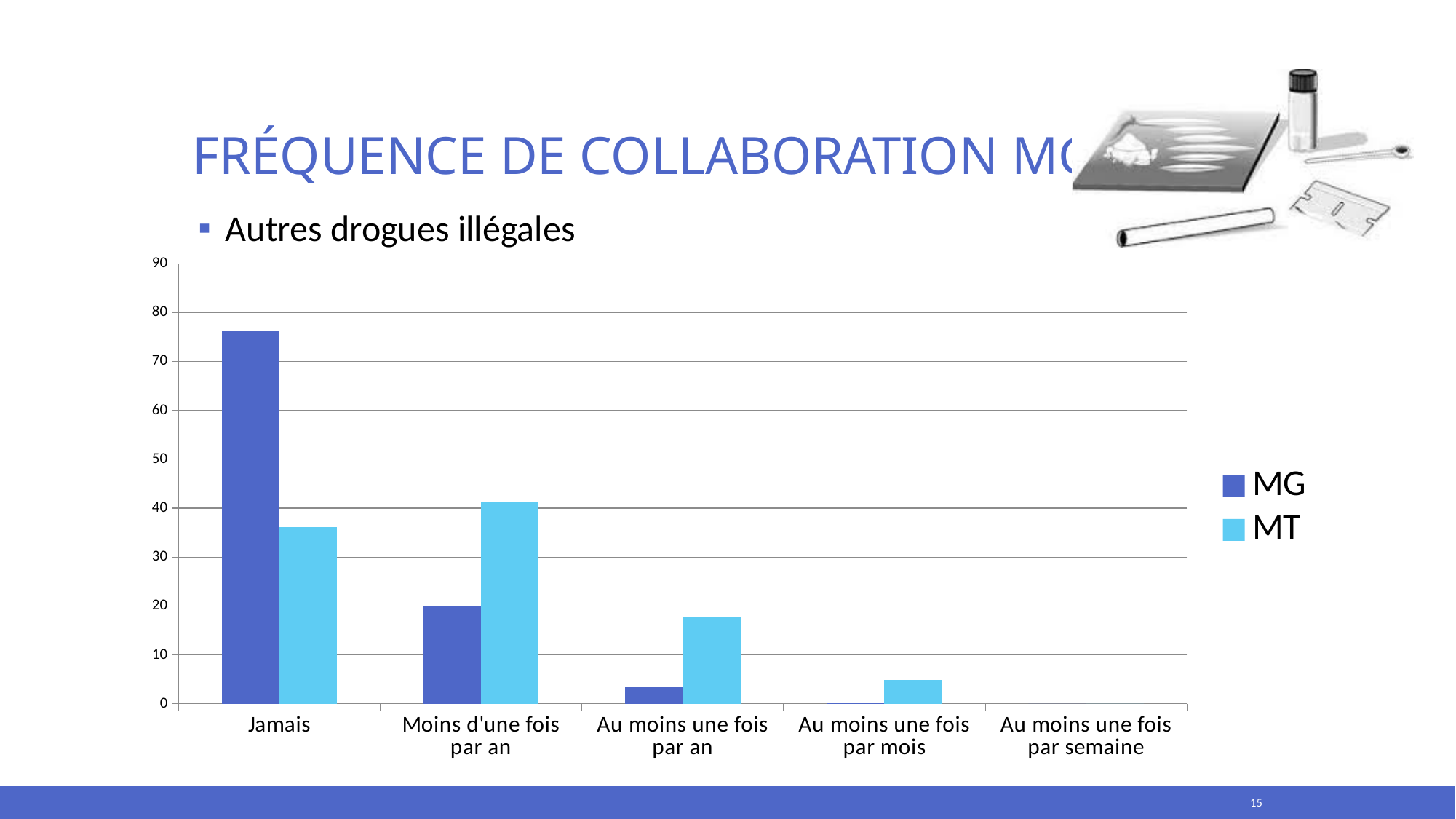
Is the MT value for Au moins une fois par an greater or less than 20? less Is the MG value for Jamais greater or less than 70? greater How many series does the legend list? 2 Is the MT value for Moins d'une fois par an greater or less than 40? greater How many categories are shown on the x axis? 5 For Au moins une fois par an, which series has the larger value, MG or MT? MT Which category has the highest MG value? Jamais For Jamais, which series has the larger value, MG or MT? MG What are the two legend entries of the chart? MG and MT Which category has the highest MT value? Moins d'une fois par an What kind of chart is shown on the slide? bar chart